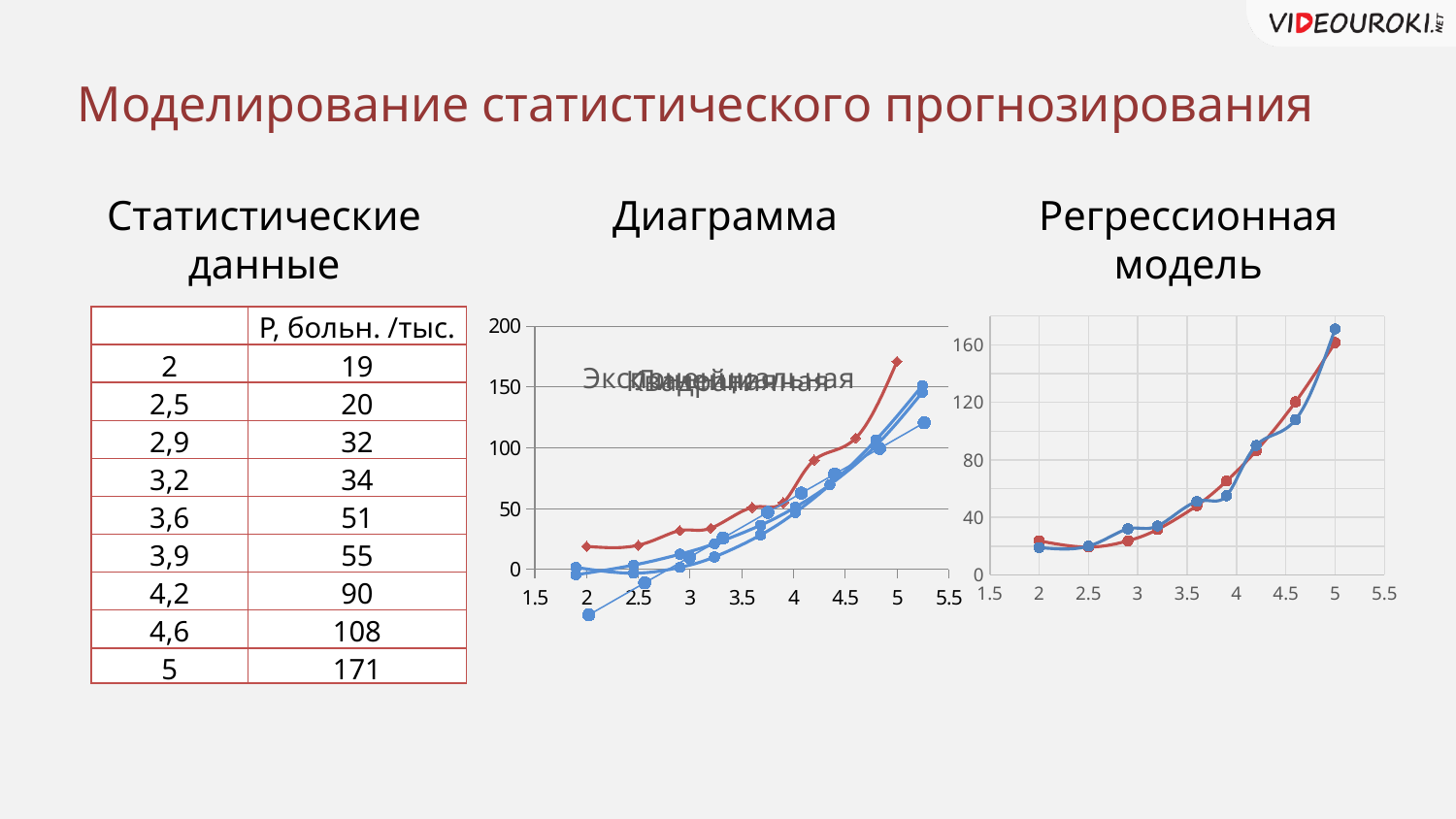
In the 'Диаграмма' chart, is the red series value at x = 5 greater or less than 150? greater In the 'Регрессионная модель' chart, do the values rise or fall as x increases from 2 to 5? rise What kind of chart is the 'Диаграмма' chart in the middle of the slide? line chart What kind of chart is the 'Регрессионная модель' chart on the right? line chart In the 'Регрессионная модель' chart, is the blue series value at x = 4.6 greater or less than 120? less In the 'Регрессионная модель' chart, is the blue series value at x = 5 greater or less than 160? greater What is the highest value shown on the y axis of the 'Диаграмма' chart? 200 What is the highest value shown on the y axis of the 'Регрессионная модель' chart? 160 In the 'Регрессионная модель' chart, which series is higher at x = 5, the blue one or the red one? blue How many blue data points are plotted in the 'Регрессионная модель' chart? 9